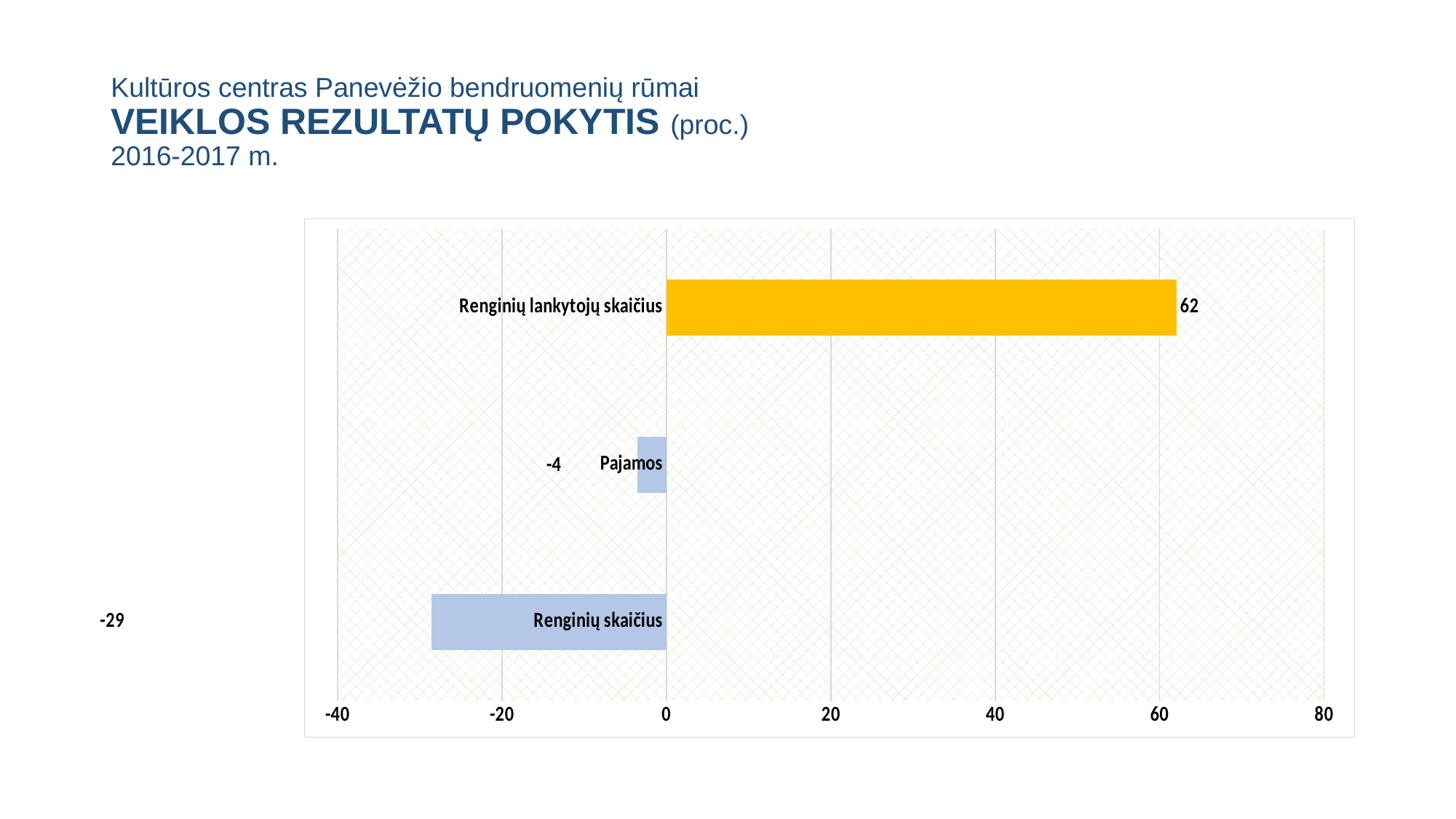
How many categories are shown in the chart? 3 What colour is the bar for Renginių lankytojų skaičius? yellow What is the value for Pajamos? -4 Which category has the lowest value? Renginių skaičius What is the value for Renginių lankytojų skaičius? 62 Which category has the highest value? Renginių lankytojų skaičius What is the difference between the values for Renginių lankytojų skaičius and Renginių skaičius? 91 Is the value for Renginių lankytojų skaičius greater or less than 40? greater What kind of chart is shown on the slide? bar chart What is the value for Renginių skaičius? -29 What is the difference between the values for Pajamos and Renginių skaičius? 25 Which is larger, the value for Pajamos or the value for Renginių skaičius? Pajamos